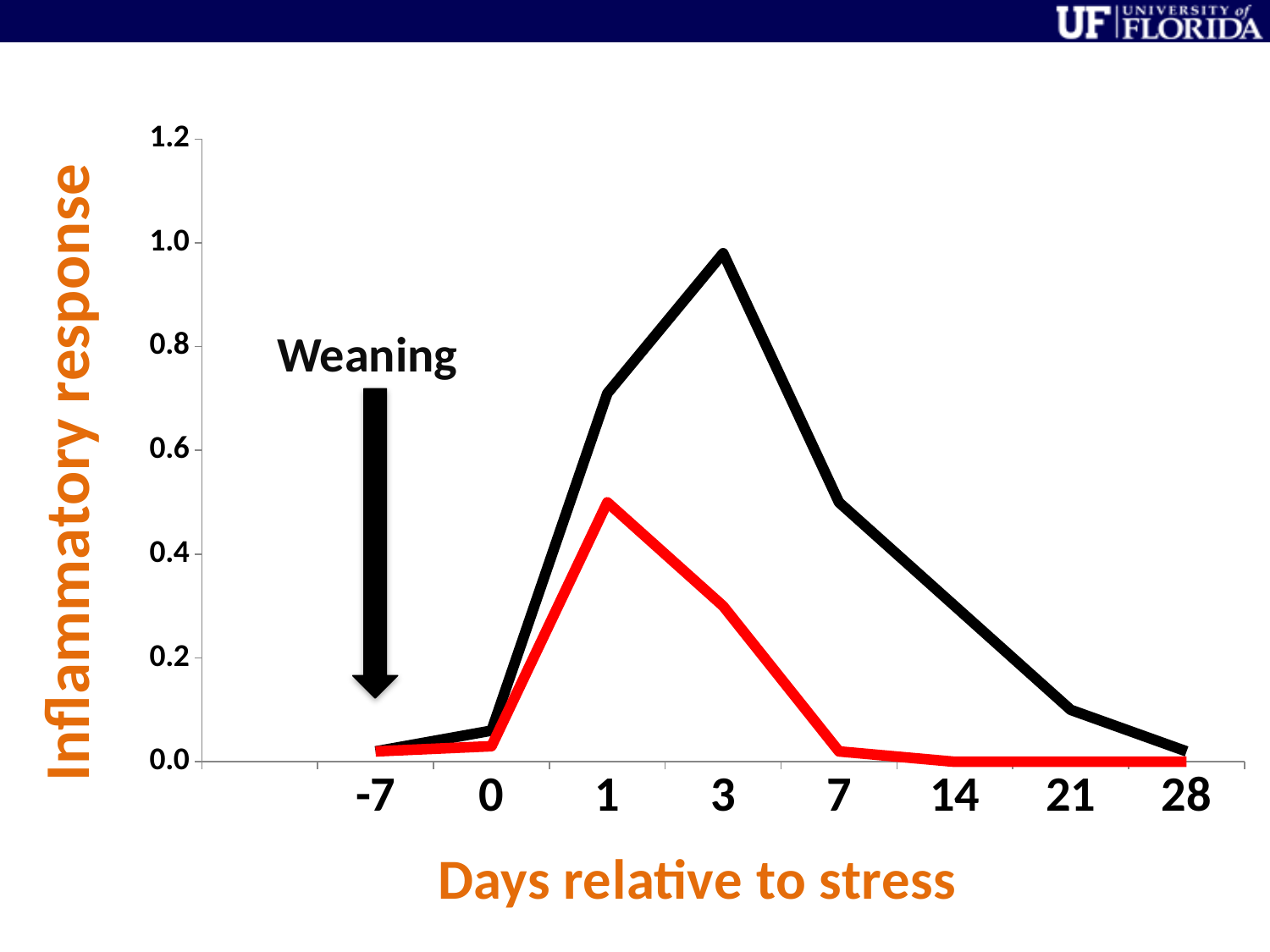
What is the title of the x axis? Days relative to stress Is the value of the black line at day 21 greater or less than 0.2? less What kind of chart is shown on the slide? line chart At which day does the red line reach its highest value? 1 Is the value of the red line at day 1 greater or less than 0.6? less Is the value of the red line at day 3 greater or less than 0.4? less How many lines are plotted on the chart? 2 How many day labels are shown on the x axis? 8 Does the black line rise or fall between day 3 and day 28? fall At which day does the black line reach its highest value? 3 At day 7, which line has the higher value, the black line or the red line? black line